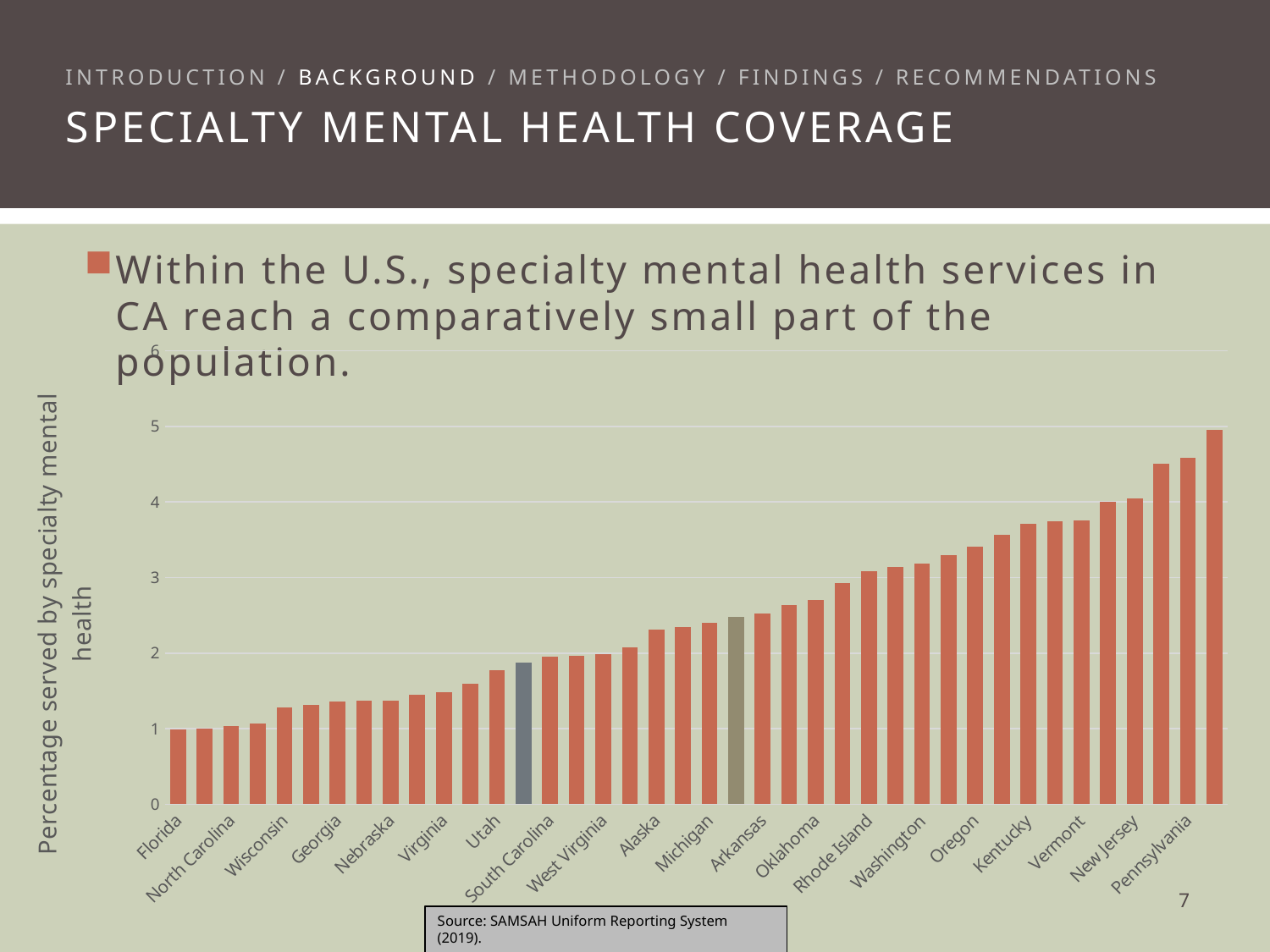
Is the value for Alaska greater or less than 2? greater Is the value for Washington greater or less than 3? greater What kind of chart is shown on the slide? bar chart What is the title of the vertical axis? Percentage served by specialty mental health Is the value for Pennsylvania greater or less than 4? greater Which state has the lowest percentage served by specialty mental health? Florida Do the bar values rise or fall moving from left to right along the x axis? rise Which has a larger value, Oregon or Georgia? Oregon Which has a larger value, Utah or Michigan? Michigan